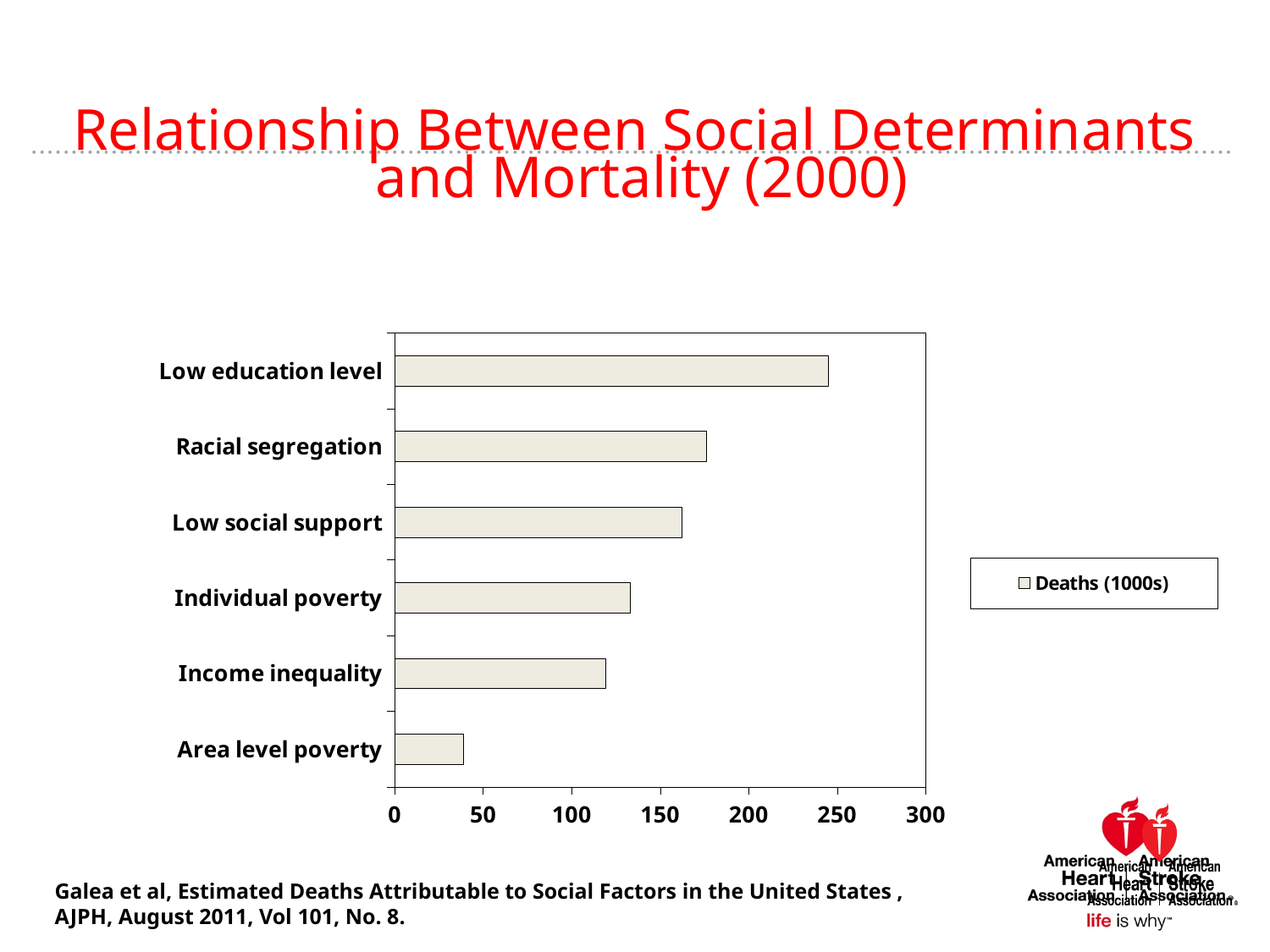
Is the value for Racial segregation greater or less than 150? greater Which is larger, the value for Racial segregation or the value for Income inequality? Racial segregation What is the series name shown in the legend? Deaths (1000s) Is the value for Individual poverty greater or less than 150? less Which category has the highest value? Low education level How many series does the legend list? 1 Is the value for Low education level greater or less than 200? greater How many categories are plotted in the chart? 6 Which category has the lowest value? Area level poverty Which is larger, the value for Individual poverty or the value for Low social support? Low social support What kind of chart is shown on the slide? bar chart